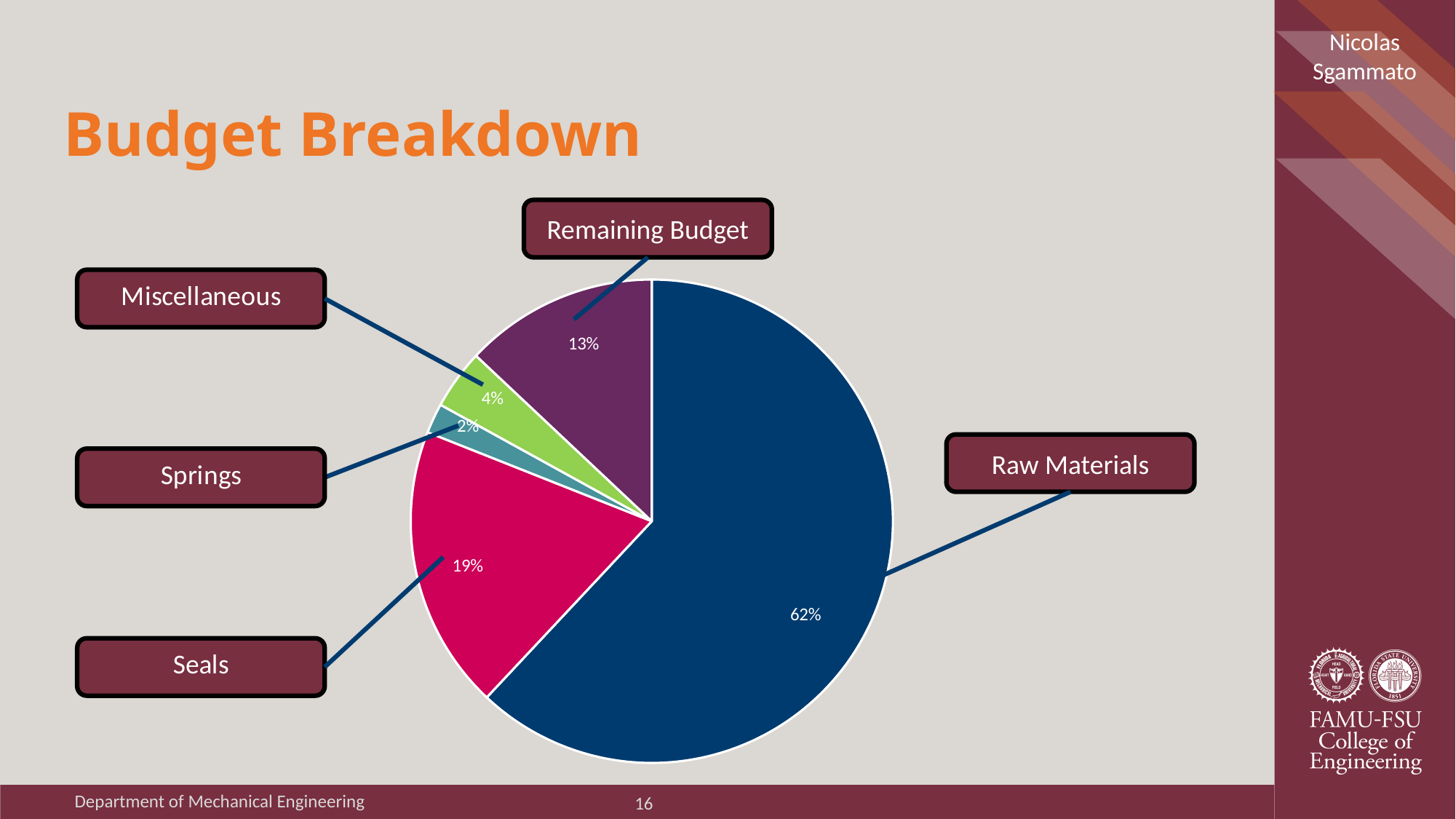
What share of the budget is Raw Materials? 62% What share of the budget is the Remaining Budget? 13% Which category has the smallest slice of the pie? Springs What kind of chart is shown on the slide? Pie chart What share of the budget is Seals? 19% What is the difference in percentage points between Raw Materials and Seals? 43 What share of the budget is Miscellaneous? 4% What is the title of the slide containing the chart? Budget Breakdown What share of the budget is Springs? 2% How many slices does the pie chart have? 5 Which is larger, the Seals slice or the Remaining Budget slice? Seals Which category has the largest slice of the pie? Raw Materials